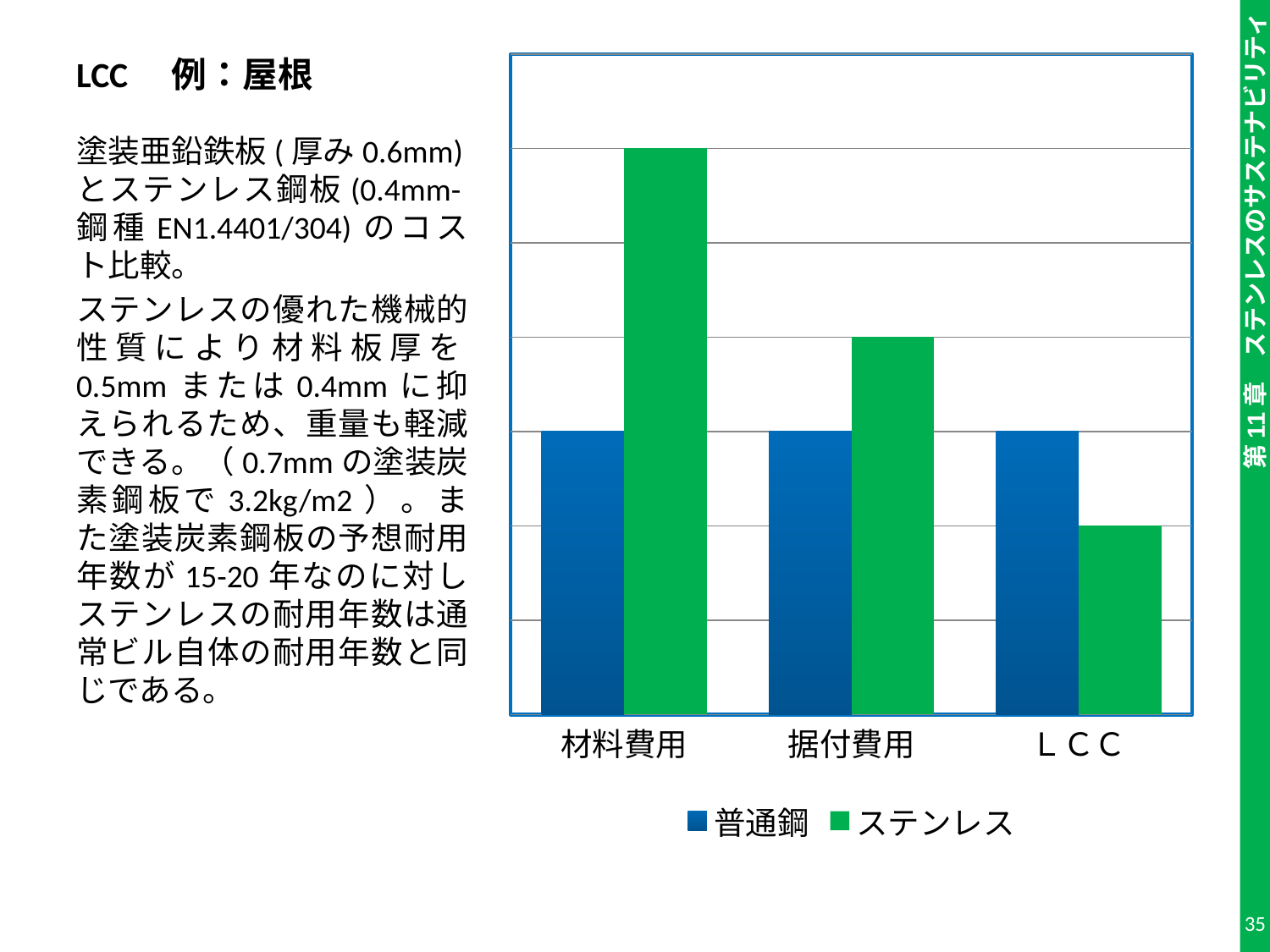
For the ステンレス series, which category has the lowest value? ＬＣＣ What kind of chart is shown on the slide? bar chart Which colour represents the 普通鋼 series in the chart? blue Which series has the higher value for ＬＣＣ, 普通鋼 or ステンレス? 普通鋼 Which series has the higher value for 据付費用, 普通鋼 or ステンレス? ステンレス Is the ステンレス value for 据付費用 greater or less than the ステンレス value for ＬＣＣ? greater How many categories are shown on the x axis of the chart? 3 For the ステンレス series, which category has the highest value? 材料費用 Do the ステンレス values rise or fall from 材料費用 to ＬＣＣ along the x axis? fall Which colour represents the ステンレス series in the chart? green How many series does the chart legend list? 2